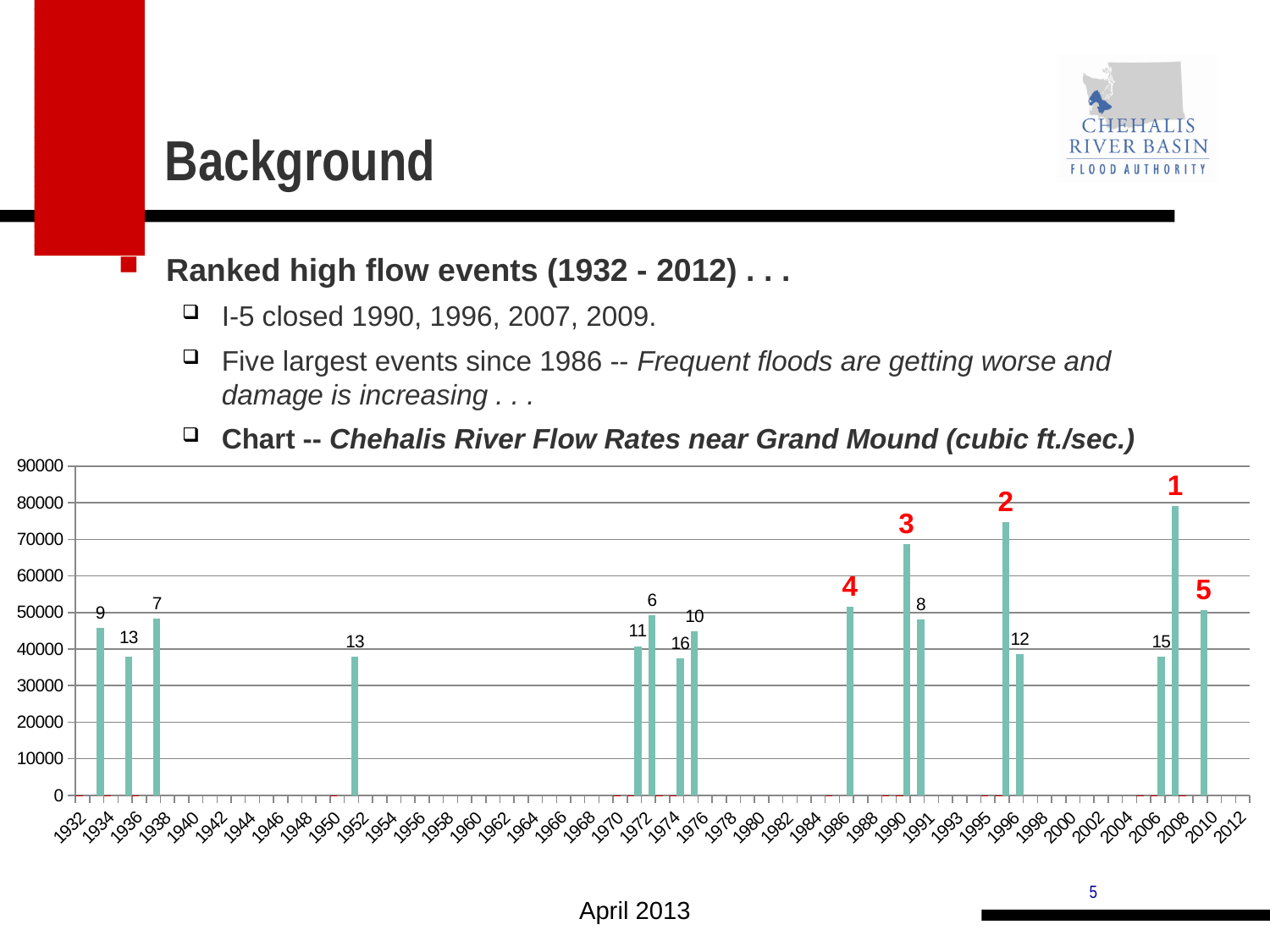
Which is larger, the bar labelled 1 or the bar labelled 2? the bar labelled 1 Is the value of the bar labelled 3 greater or less than 60000? greater What kind of chart is shown on the slide? bar chart Is the value of the bar labelled 15 greater or less than 40000? less Is the value of the bar labelled 1 greater or less than 70000? greater What is the highest value shown on the chart's vertical axis? 90000 Which is larger, the bar labelled 3 or the bar labelled 4? the bar labelled 3 What is the title of the chart as given in the bullet text? Chehalis River Flow Rates near Grand Mound (cubic ft./sec.) Which rank label is shown above the tallest bar in the chart? 1